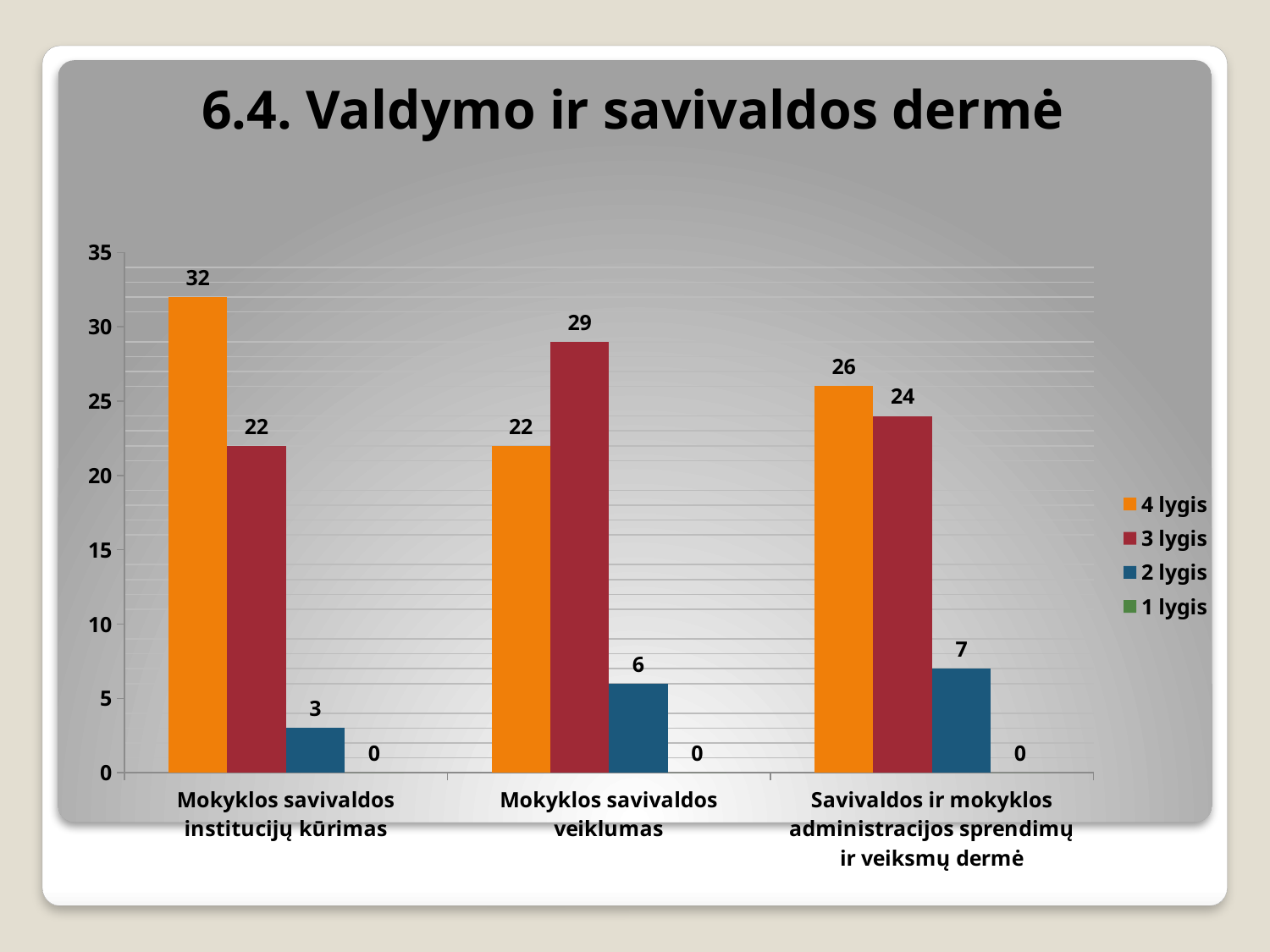
For "Mokyklos savivaldos veiklumas", which is larger: the "4 lygis" value or the "3 lygis" value? 3 lygis How many categories are shown on the x axis? 3 What is the title of the slide? 6.4. Valdymo ir savivaldos dermė What is the value of the "4 lygis" series for "Mokyklos savivaldos institucijų kūrimas"? 32 Which category has the lowest value for the "2 lygis" series? Mokyklos savivaldos institucijų kūrimas Which category has the highest value for the "4 lygis" series? Mokyklos savivaldos institucijų kūrimas What is the difference between the "4 lygis" and "3 lygis" values for "Mokyklos savivaldos institucijų kūrimas"? 10 What kind of chart is shown on the slide? bar chart What is the value of the "2 lygis" series for "Savivaldos ir mokyklos administracijos sprendimų ir veiksmų dermė"? 7 What is the value of the "1 lygis" series for "Mokyklos savivaldos veiklumas"? 0 How many series does the legend list? 4 What is the value of the "3 lygis" series for "Mokyklos savivaldos veiklumas"? 29